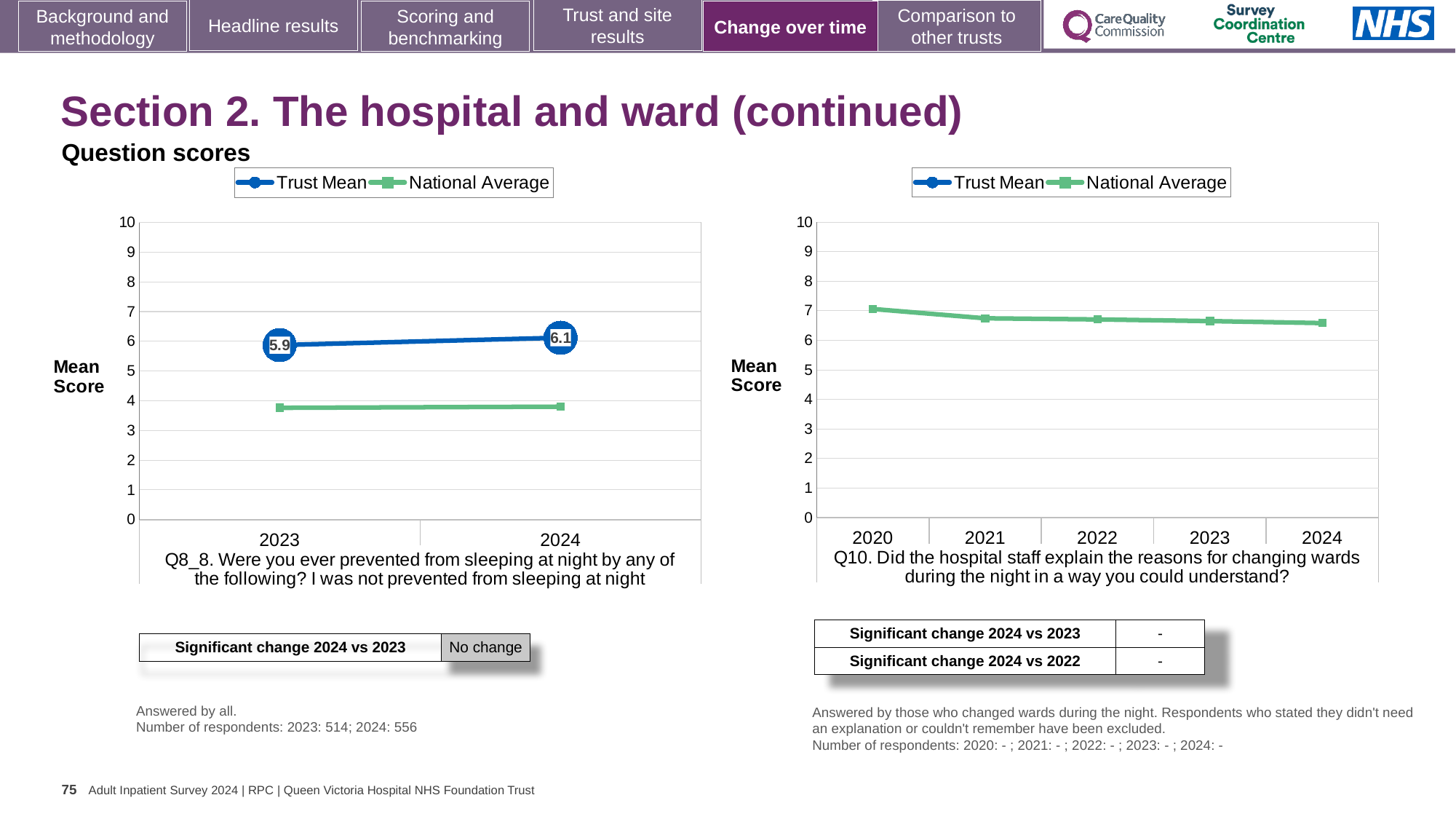
On the right chart (Q10), does the National Average rise or fall from 2020 to 2024? fall On the left chart (Q8_8), what is the Trust Mean score for 2024? 6.1 On the right chart (Q10), is the National Average for 2020 greater or less than 6? greater What is the y-axis label on the left chart (Q8_8)? Mean Score On the left chart (Q8_8), which series is higher in 2023, Trust Mean or National Average? Trust Mean On the left chart (Q8_8), what is the Trust Mean score for 2023? 5.9 On the left chart (Q8_8), which year has the higher Trust Mean, 2023 or 2024? 2024 What type of chart is the right chart (Q10)? line chart How many years are shown on the x axis of the right chart (Q10)? 5 How many series does the legend of the left chart (Q8_8) list? 2 On the left chart (Q8_8), by how much did the Trust Mean change from 2023 to 2024? 0.2 On the left chart (Q8_8), is the National Average for 2024 greater or less than 5? less